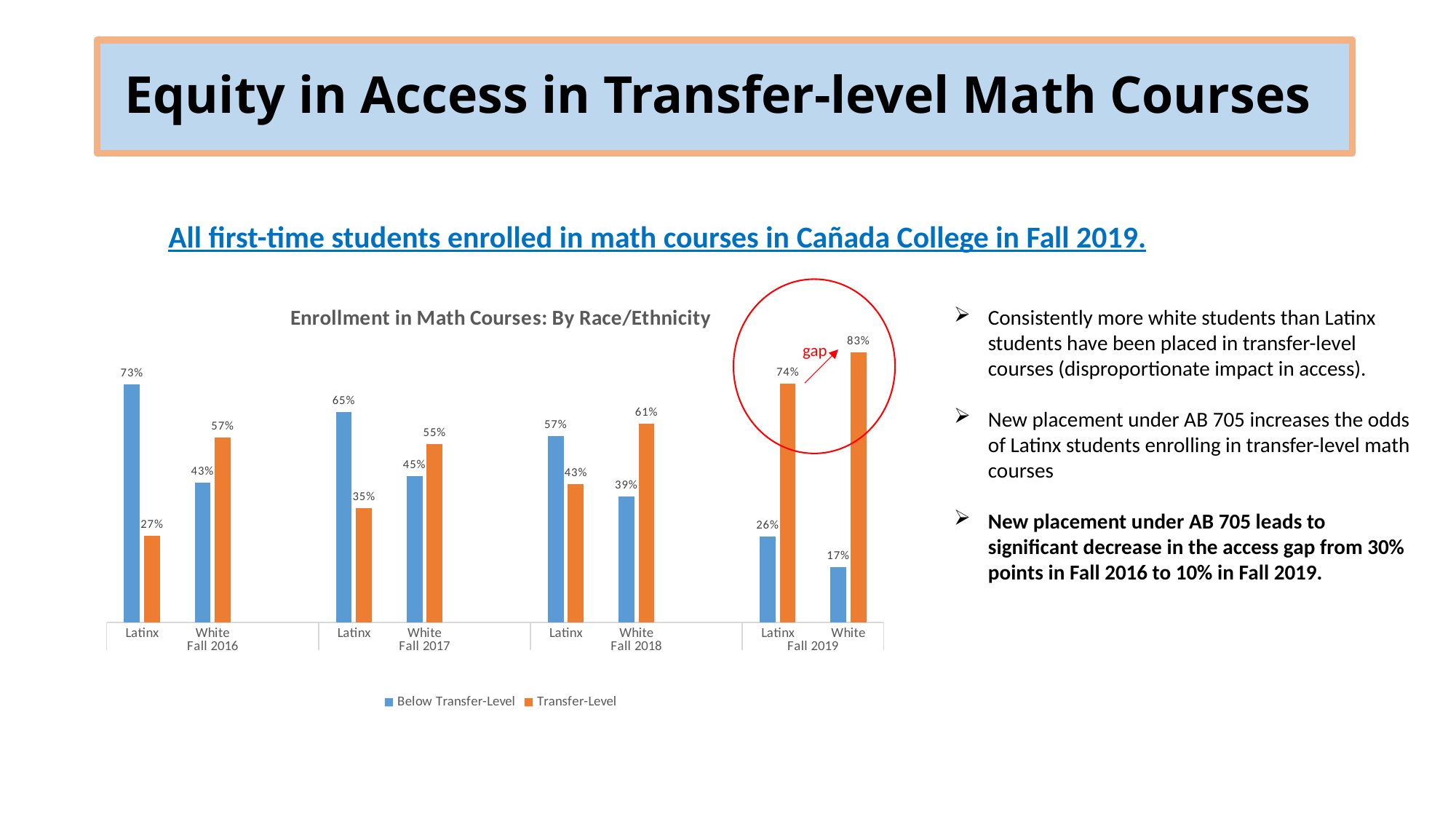
Which is larger: the Transfer-Level value for Latinx students in Fall 2018 or in Fall 2019? Fall 2019 Which group and term has the lowest Below Transfer-Level value? White, Fall 2019 What is the Transfer-Level value for Latinx students in Fall 2017? 35% How does the Transfer-Level value for Latinx students change from Fall 2016 to Fall 2019? It rises What is the title of the chart? Enrollment in Math Courses: By Race/Ethnicity Which group and term has the highest Transfer-Level value? White, Fall 2019 What is the Below Transfer-Level value for Latinx students in Fall 2016? 73% What is the difference between the Transfer-Level values for White and Latinx students in Fall 2016? 30% How many series does the legend list? 2 What is the Transfer-Level value for White students in Fall 2019? 83% What is the difference between the Transfer-Level values for White and Latinx students in Fall 2019? 9% What kind of chart is shown? Bar chart